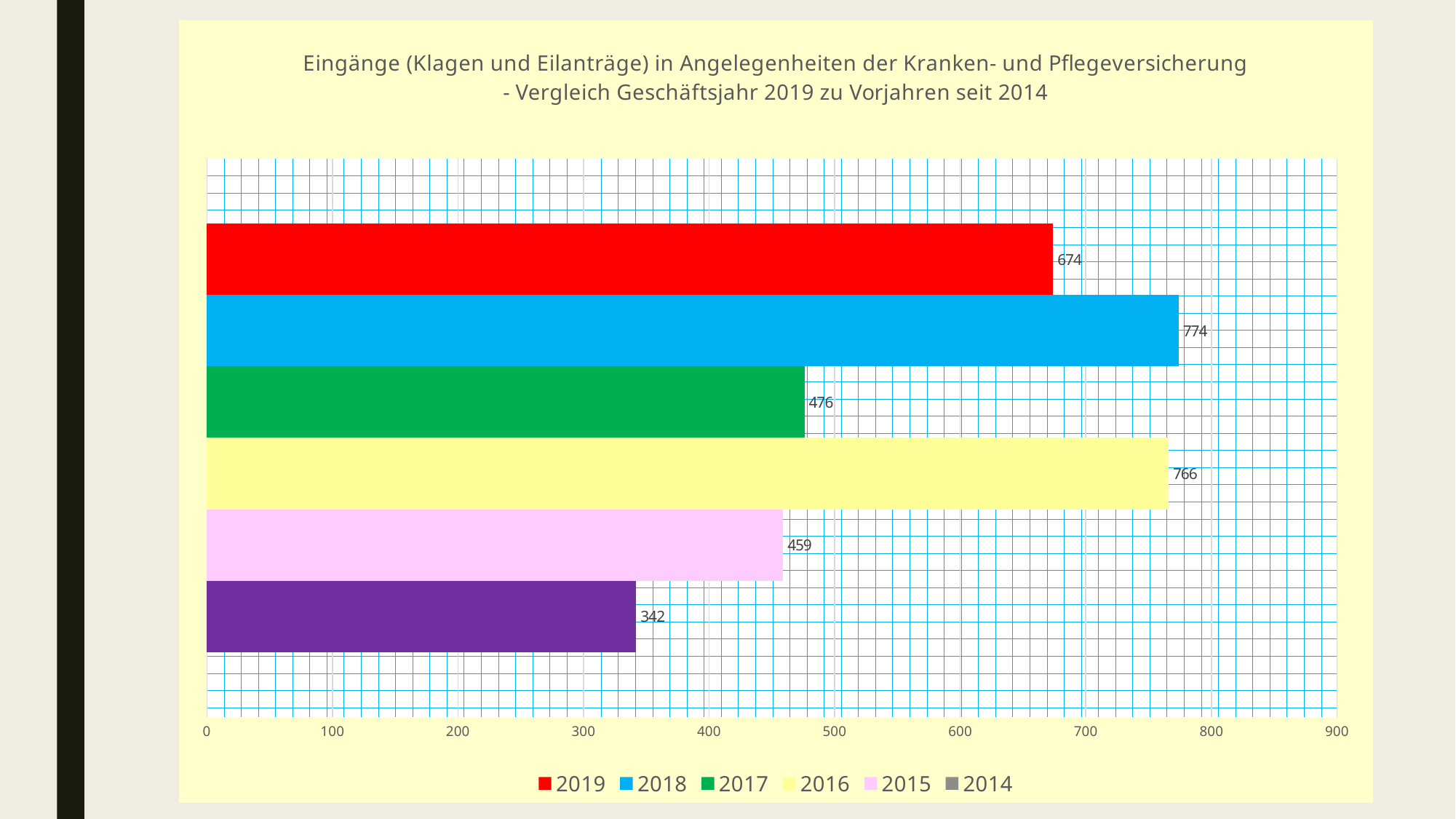
Which colour represents 2019 in the legend? Red What is the value for 2018? 774 What is the value for 2016? 766 What is the difference between the values for 2018 and 2019? 100 What is the value for 2019? 674 Which year has the lowest value? 2014 What kind of chart is shown on the slide? Bar chart Which year has the highest value? 2018 What is the value for 2017? 476 How many series does the legend list? 6 Which is larger, the value for 2017 or the value for 2015? 2017 What is the value for 2015? 459